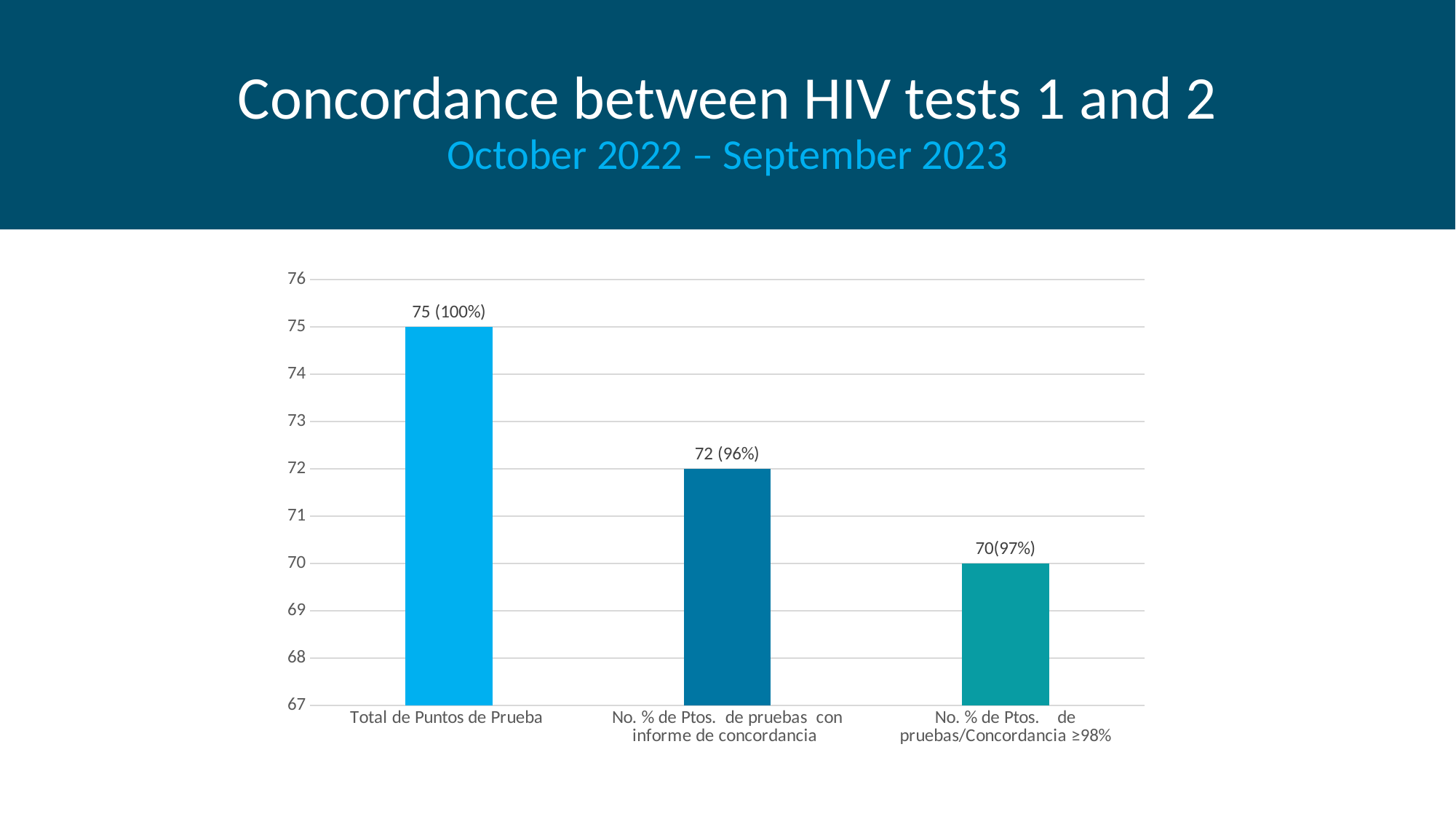
What kind of chart is shown on the slide? Bar chart What is the data label shown for 'No. % de Ptos. de pruebas/Concordancia ≥98%'? 70(97%) What is the data label shown for 'Total de Puntos de Prueba'? 75 (100%) What period does the slide subtitle cover? October 2022 – September 2023 Which category has the highest bar? Total de Puntos de Prueba What is the difference in count between 'Total de Puntos de Prueba' and 'No. % de Ptos. de pruebas con informe de concordancia'? 3 Which is larger: the count for 'No. % de Ptos. de pruebas con informe de concordancia' or for 'No. % de Ptos. de pruebas/Concordancia ≥98%'? No. % de Ptos. de pruebas con informe de concordancia How many categories are shown on the chart? 3 Which category has the lowest bar? No. % de Ptos. de pruebas/Concordancia ≥98% Do the bar values rise or fall from left to right across the chart? Fall What is the difference in count between 'No. % de Ptos. de pruebas con informe de concordancia' and 'No. % de Ptos. de pruebas/Concordancia ≥98%'? 2 What is the data label shown for 'No. % de Ptos. de pruebas con informe de concordancia'? 72 (96%)